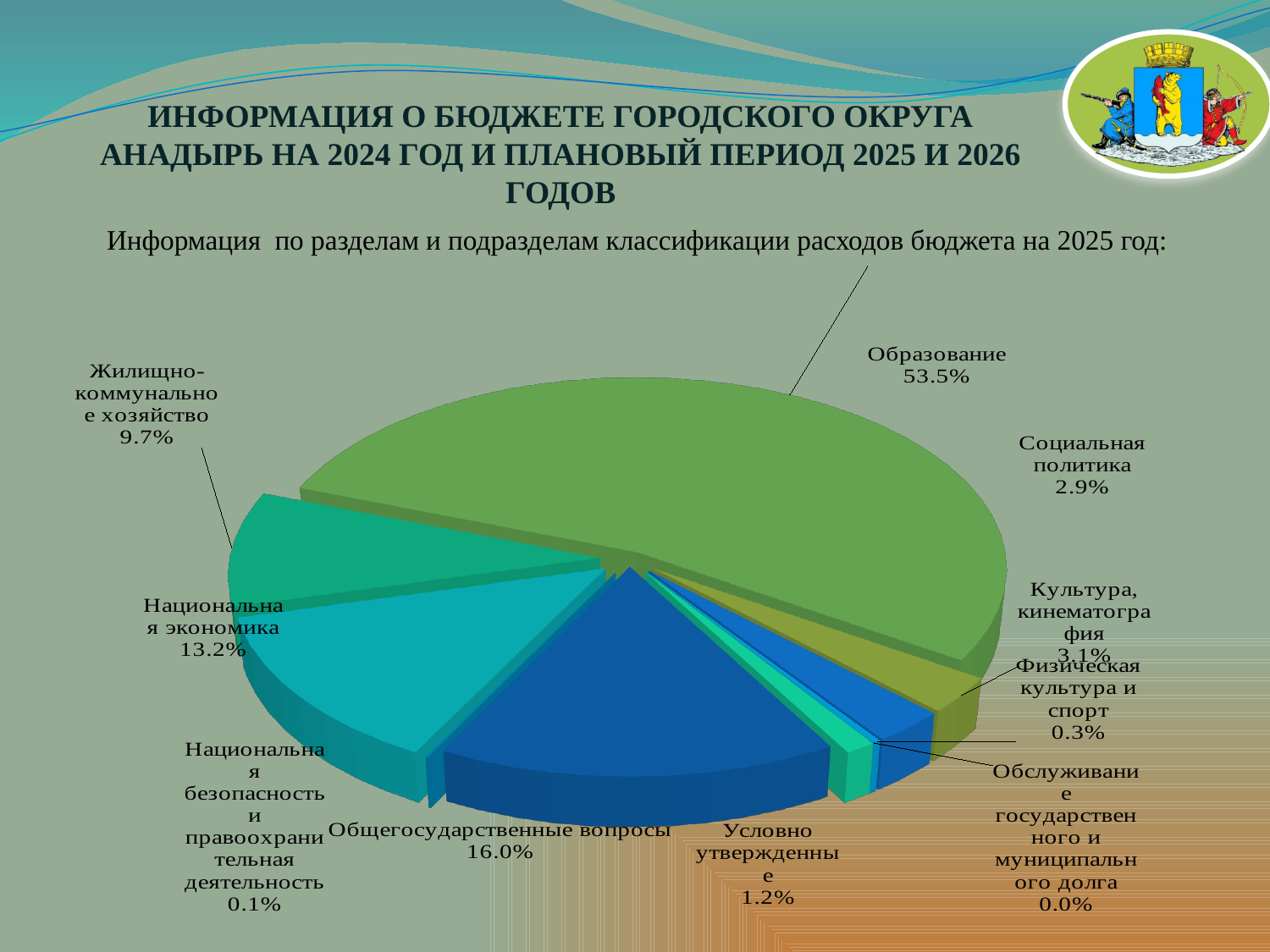
What percentage is shown for Условно утвержденные? 1.2% What percentage is shown for Национальная экономика? 13.2% What share is labelled for Жилищно-коммунальное хозяйство? 9.7% What share of the 2025 budget expenditures goes to Образование? 53.5% What percentage is shown for Общегосударственные вопросы? 16.0% Which year's budget expenditures does the pie chart describe? 2025 What is the difference between the shares of Образование and Общегосударственные вопросы? 37.5% Which section has the smallest share of the pie? Обслуживание государственного и муниципального долга Which section has the largest share of the pie? Образование Which is larger: the share of Культура, кинематография or the share of Социальная политика? Культура, кинематография How many sections (slices) are shown in the pie chart? 10 What type of chart is shown on the slide? Pie chart